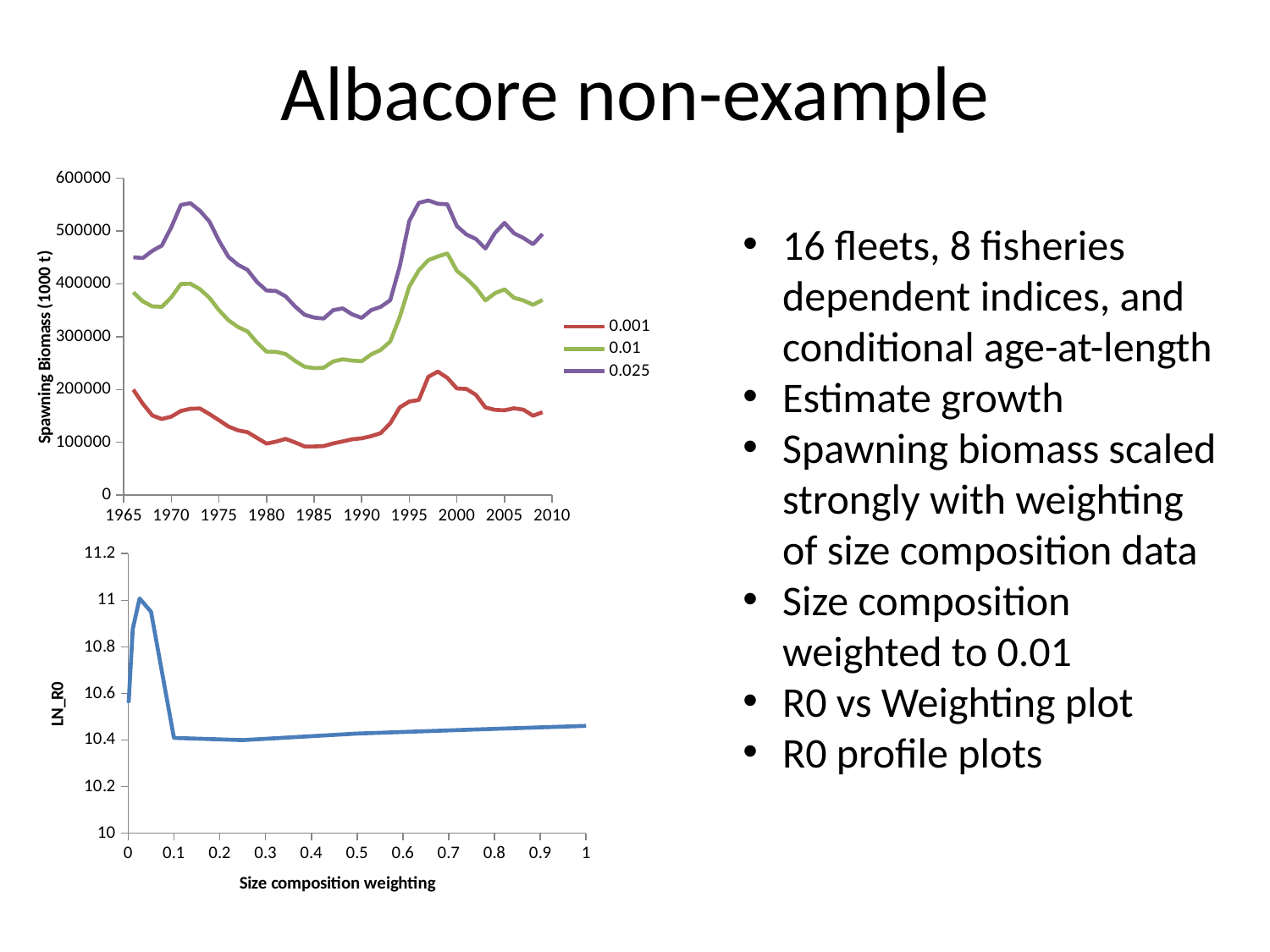
In the top chart (Spawning Biomass), what kind of chart is shown? line chart In the top chart (Spawning Biomass), which series has the highest values across the years? 0.025 In the bottom chart (LN_R0 vs Size composition weighting), is the peak value near a weighting of 0.03 greater or less than 10.8? greater In the top chart (Spawning Biomass), which series has the lowest values across the years? 0.001 In the top chart (Spawning Biomass), is the value for the 0.01 series around 1985 greater or less than 300000? less In the bottom chart (LN_R0 vs Size composition weighting), what is the label of the x axis? Size composition weighting In the top chart (Spawning Biomass), is the value for the 0.001 series around 1998 greater or less than 200000? greater In the top chart (Spawning Biomass), how many series does the legend list? 3 In the top chart (Spawning Biomass), what are the legend entries? 0.001, 0.01, 0.025 In the bottom chart (LN_R0 vs Size composition weighting), what kind of chart is shown? line chart